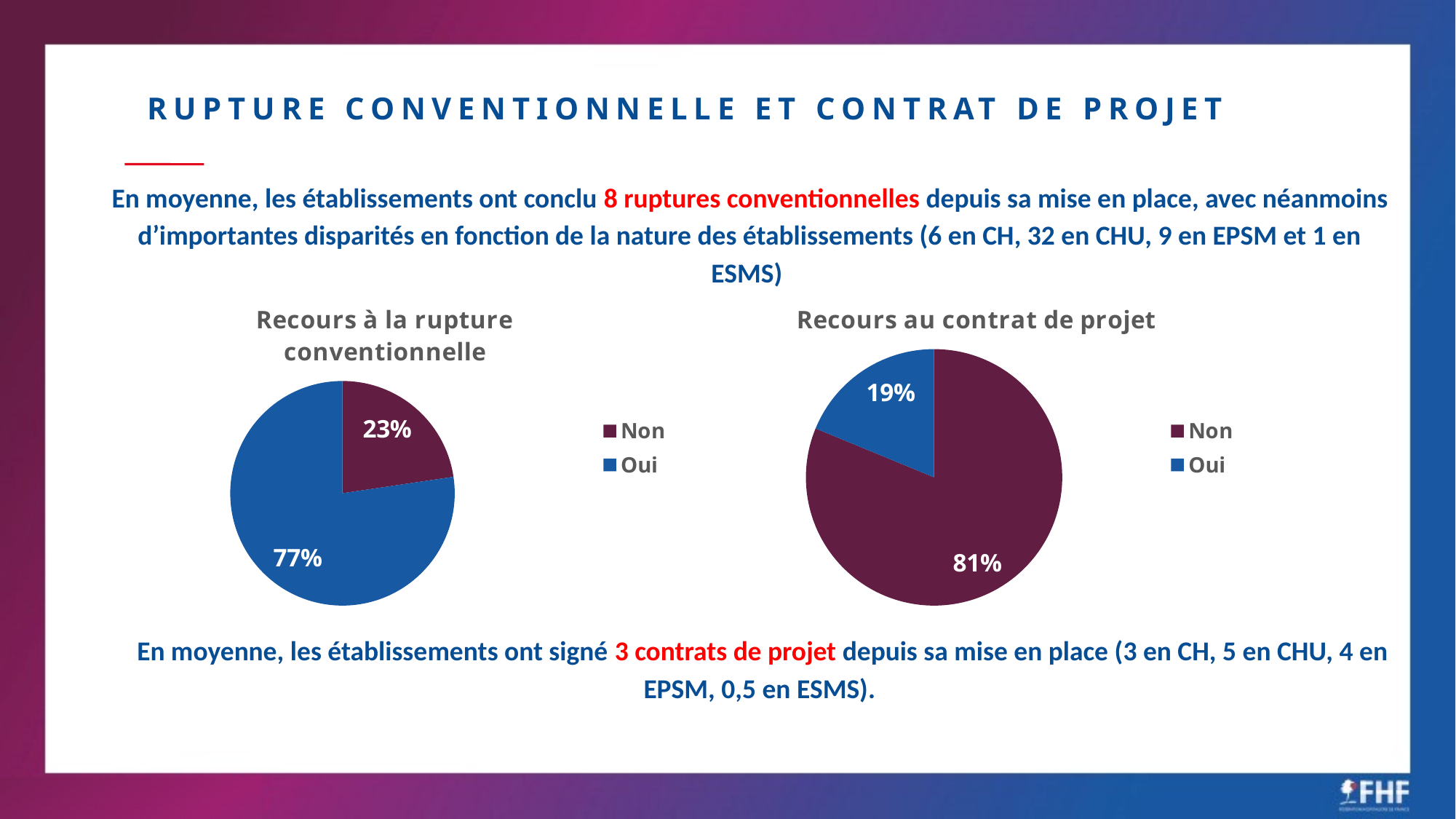
In the 'Recours à la rupture conventionnelle' chart, what share is labelled for Non? 23% In the 'Recours à la rupture conventionnelle' chart, what share is labelled for Oui? 77% In the 'Recours au contrat de projet' chart, which slice is the smallest? Oui In the 'Recours au contrat de projet' chart, what is the difference in percentage points between Non and Oui? 62 In the 'Recours à la rupture conventionnelle' chart, which slice is the largest? Oui In the 'Recours à la rupture conventionnelle' chart, what is the difference in percentage points between Oui and Non? 54 How many slices does the 'Recours au contrat de projet' chart have? 2 In the 'Recours au contrat de projet' chart, what share is labelled for Oui? 19% In the 'Recours à la rupture conventionnelle' chart, what colour is the Oui slice? Blue In the 'Recours au contrat de projet' chart, what share is labelled for Non? 81% In the 'Recours au contrat de projet' chart, which is larger, Oui or Non? Non What kind of chart is 'Recours à la rupture conventionnelle'? Pie chart